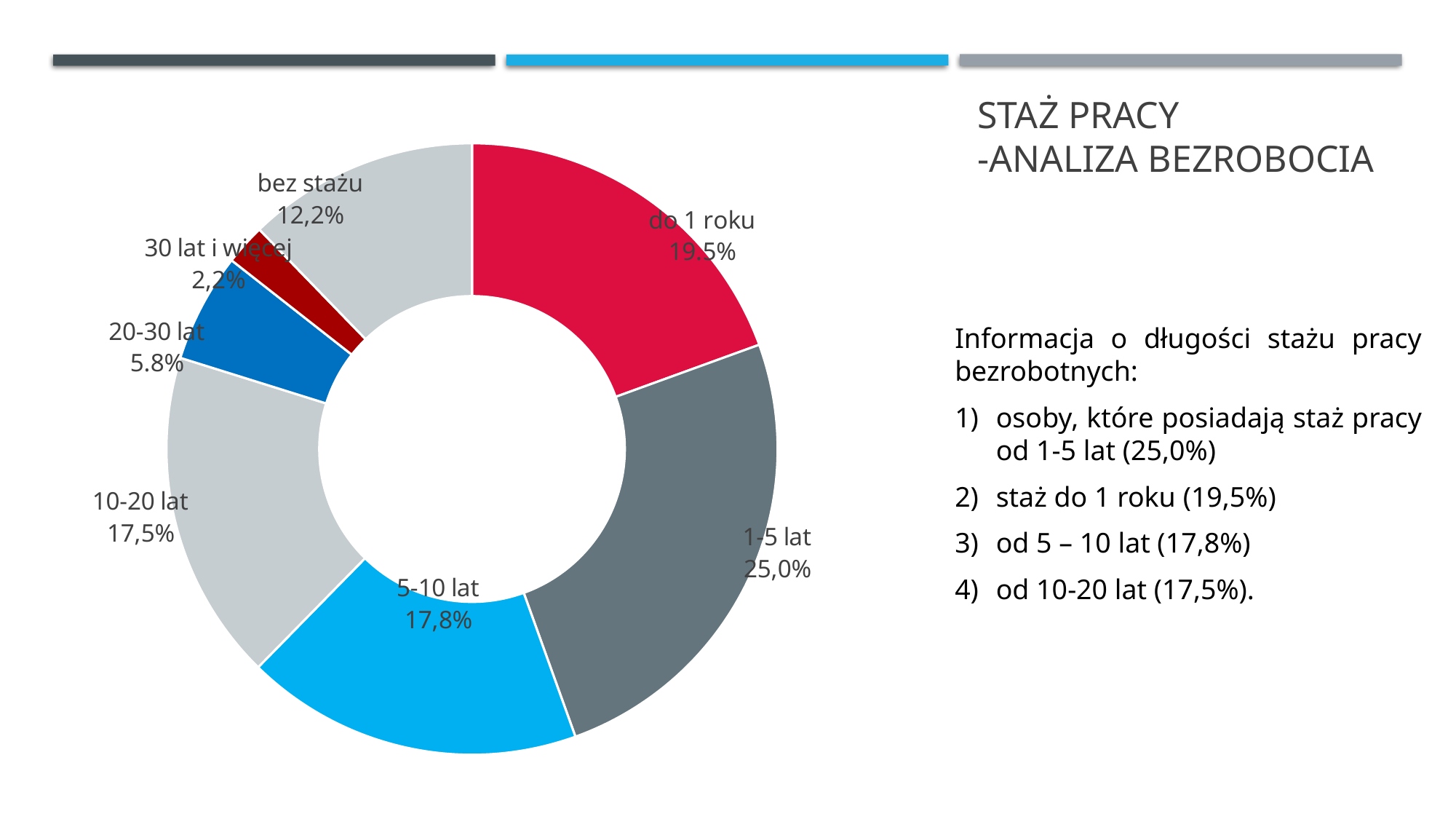
What share of the pie does the '1-5 lat' slice represent? 25,0% Which category has the smallest share of the chart? 30 lat i więcej What is the difference between the shares of '1-5 lat' and 'do 1 roku'? 5,5% What percentage is shown for '20-30 lat'? 5.8% What is the difference between the shares of '5-10 lat' and '10-20 lat'? 0,3% What is the value shown for 'bez stażu'? 12,2% Which category has the largest share of the chart? 1-5 lat Which is larger, the share for '5-10 lat' or for '10-20 lat'? 5-10 lat How many categories are shown in the chart? 7 What is the value for '30 lat i więcej'? 2,2% Which is larger, the share for 'bez stażu' or for '20-30 lat'? bez stażu What kind of chart is shown on the slide? doughnut chart